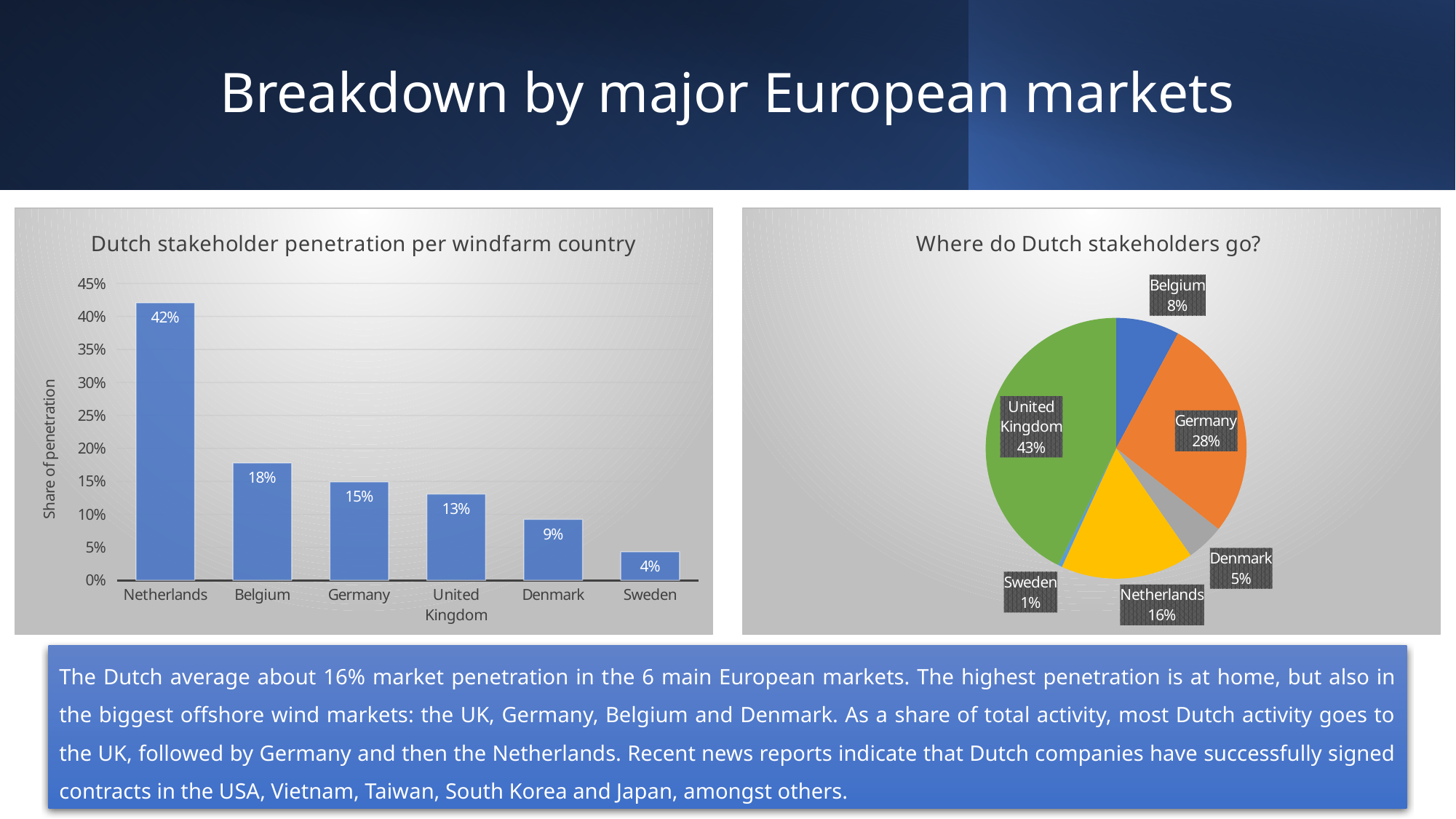
In the 'Where do Dutch stakeholders go?' chart, which country has the largest slice? United Kingdom What is the y-axis label of the 'Dutch stakeholder penetration per windfarm country' chart? Share of penetration What kind of chart is 'Dutch stakeholder penetration per windfarm country'? Bar chart In the 'Dutch stakeholder penetration per windfarm country' chart, which country has the lowest share of penetration? Sweden In the 'Dutch stakeholder penetration per windfarm country' chart, how many countries are shown? 6 In the 'Dutch stakeholder penetration per windfarm country' chart, which country has the highest share of penetration? Netherlands What kind of chart is 'Where do Dutch stakeholders go?'? Pie chart In the 'Dutch stakeholder penetration per windfarm country' chart, what is the difference between the values for Netherlands and Belgium? 24% In the 'Dutch stakeholder penetration per windfarm country' chart, do the values rise or fall from left to right? Fall In the 'Where do Dutch stakeholders go?' chart, what share does Germany have? 28% In the 'Dutch stakeholder penetration per windfarm country' chart, what is the value for Germany? 15% In the 'Dutch stakeholder penetration per windfarm country' chart, which is larger, the value for United Kingdom or the value for Denmark? United Kingdom